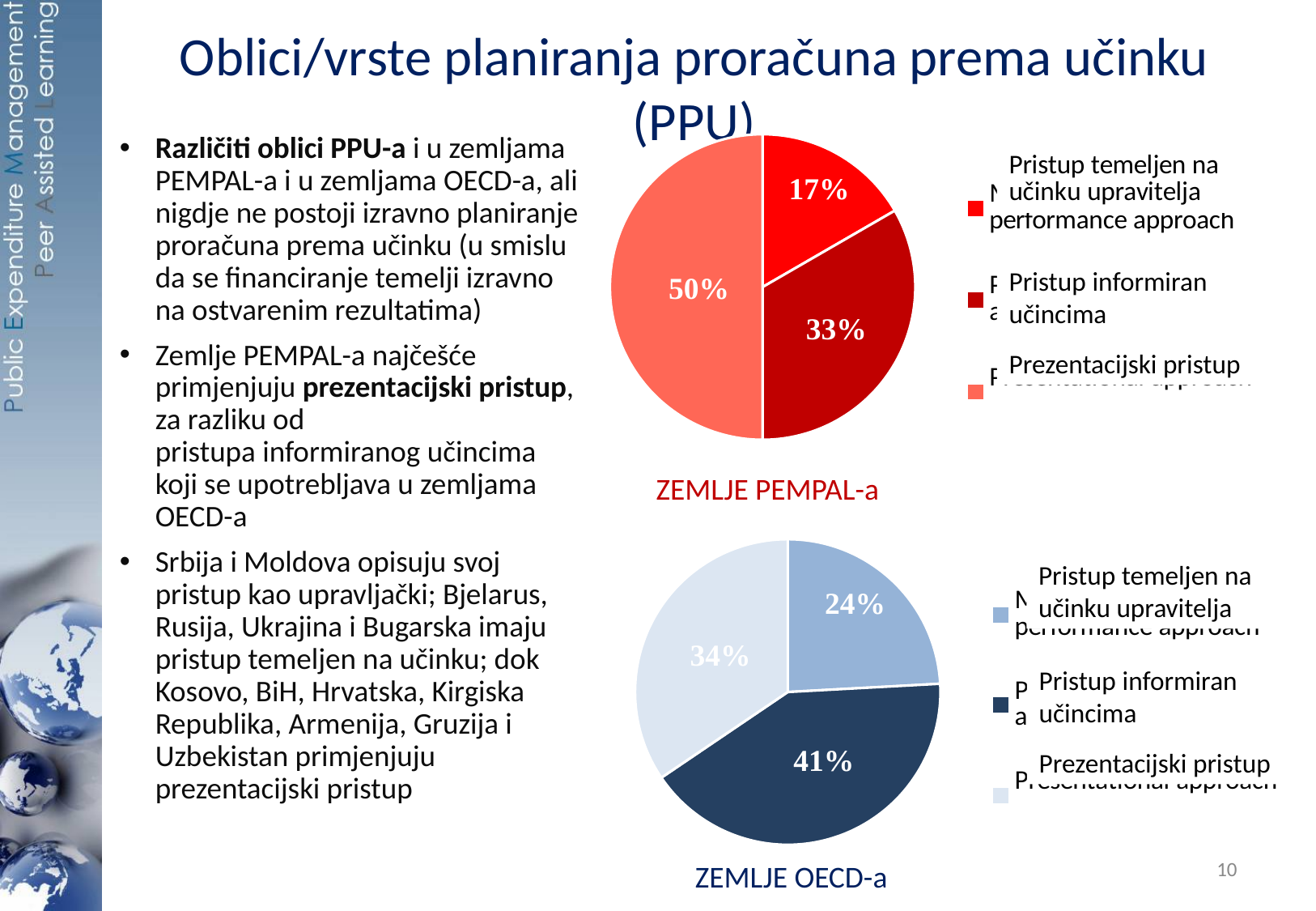
In the ZEMLJE PEMPAL-a chart, what share does Pristup informiran učincima have? 33% In the ZEMLJE PEMPAL-a chart, what share does Prezentacijski pristup have? 50% In the ZEMLJE PEMPAL-a chart, what share does Pristup temeljen na učinku upravitelja have? 17% In the ZEMLJE OECD-a chart, what share does Pristup temeljen na učinku upravitelja have? 24% In the ZEMLJE OECD-a chart, which is larger: Pristup informiran učincima or Prezentacijski pristup? Pristup informiran učincima In the ZEMLJE OECD-a chart, what share does Pristup informiran učincima have? 41% In the ZEMLJE PEMPAL-a chart, which category has the largest slice? Prezentacijski pristup In the ZEMLJE PEMPAL-a chart, what is the difference between the Prezentacijski pristup slice and the Pristup temeljen na učinku upravitelja slice? 33% How many slices does the ZEMLJE OECD-a pie chart have? 3 In the ZEMLJE OECD-a chart, what share does Prezentacijski pristup have? 34% In the ZEMLJE OECD-a chart, which category has the smallest slice? Pristup temeljen na učinku upravitelja What kind of chart is the ZEMLJE PEMPAL-a chart? Pie chart